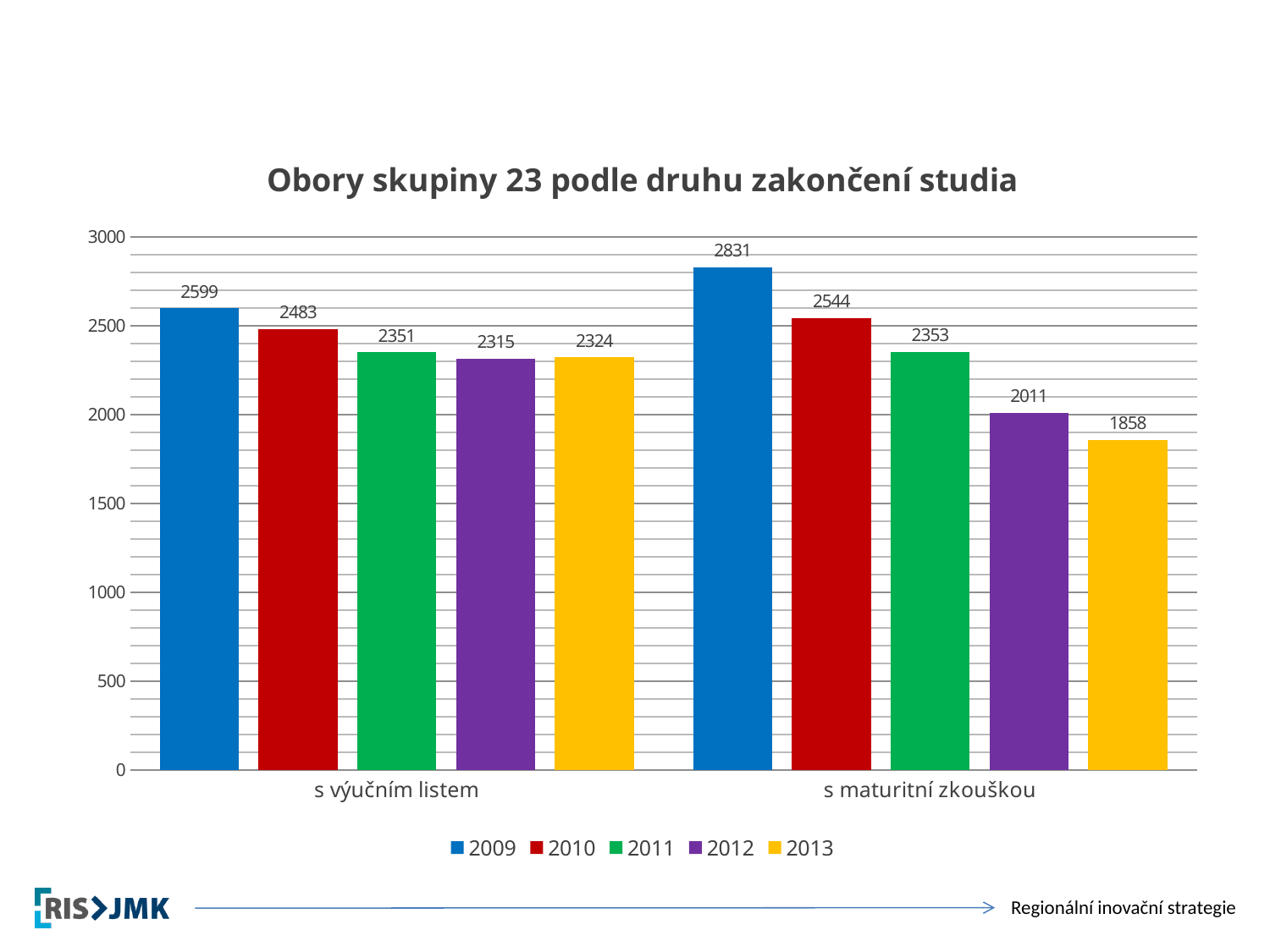
What kind of chart is shown on the slide? bar chart Which year has the lowest value in the 's výučním listem' category? 2012 What is the value for 2012 in the 's výučním listem' category? 2315 Which year has the highest value in the 's maturitní zkouškou' category? 2009 What is the value for 2009 in the 's výučním listem' category? 2599 How many series does the legend list? 5 What is the title of the chart? Obory skupiny 23 podle druhu zakončení studia Which is larger: the 2010 value for 's výučním listem' or the 2010 value for 's maturitní zkouškou'? s maturitní zkouškou What is the difference between the 2009 and 2013 values in the 's maturitní zkouškou' category? 973 How many categories are shown on the x axis? 2 What is the value for 2013 in the 's maturitní zkouškou' category? 1858 Is the value for 2012 in the 's maturitní zkouškou' category greater or less than 2500? less